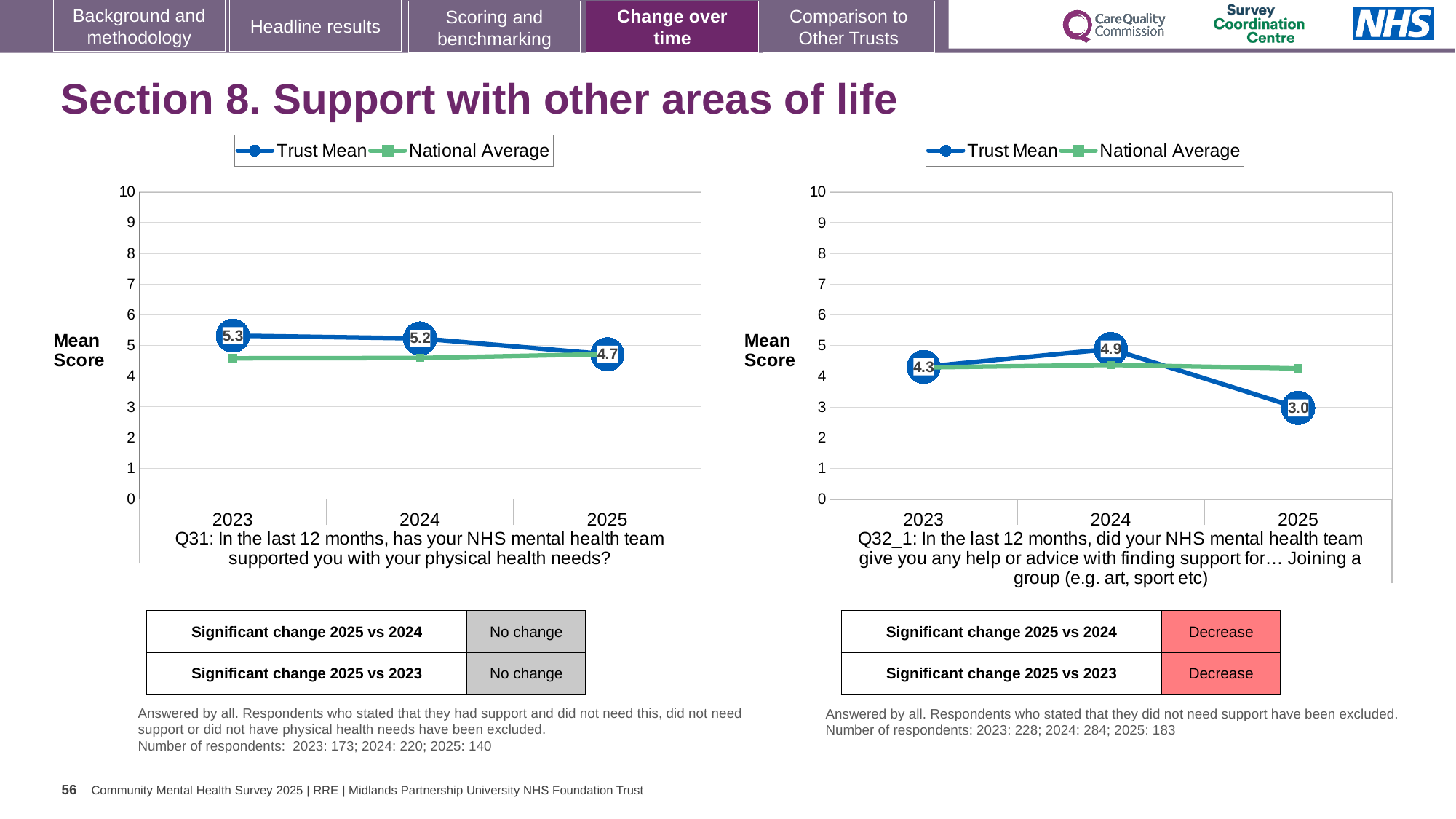
On the right chart (Q32_1), what is the Trust Mean for 2024? 4.9 On the left chart (Q31), what is the difference between the Trust Mean in 2023 and in 2025? 0.6 On the right chart (Q32_1), what is the Trust Mean for 2025? 3.0 On the left chart (Q31), is the National Average for 2023 greater or less than 5? less On the right chart (Q32_1), which year has the lowest Trust Mean? 2025 On the right chart (Q32_1), is the Trust Mean for 2025 greater or less than the National Average for 2025? less On the right chart (Q32_1), what is the difference between the Trust Mean in 2024 and in 2025? 1.9 On the left chart (Q31), what is the Trust Mean for 2023? 5.3 How many series does the legend of the left chart (Q31) list? 2 On the right chart (Q32_1), which year has the highest Trust Mean? 2024 What type of chart is used on the right (Q32_1)? Line chart On the left chart (Q31), what is the Trust Mean for 2025? 4.7